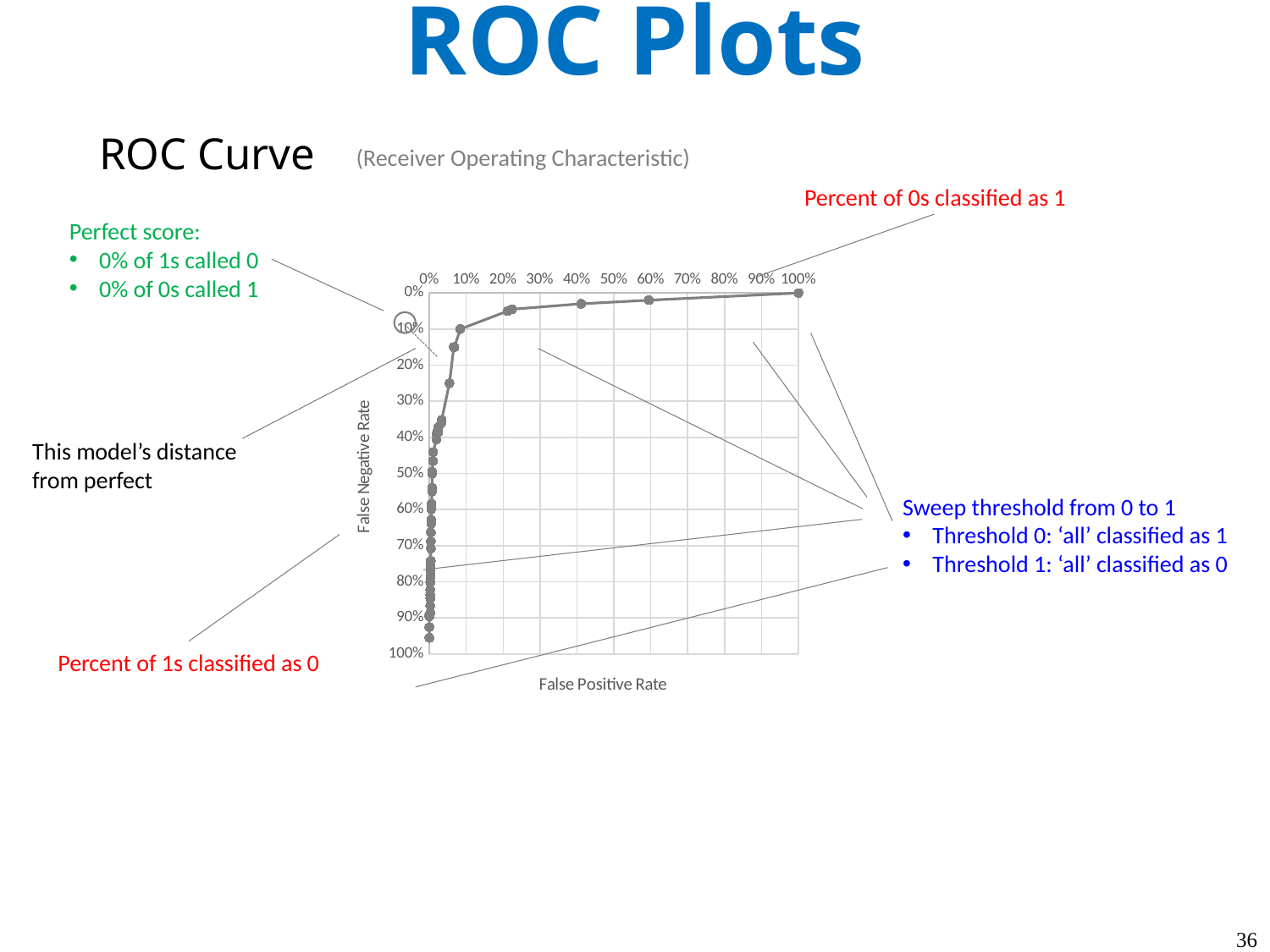
What is the False Negative Rate at a False Positive Rate of 100%? 0% What is the title of the x axis of the chart? False Positive Rate Is the False Negative Rate at a False Positive Rate of 20% greater or less than 10%? less What is the title of the y axis of the chart? False Negative Rate What kind of chart is shown on the slide? Scatter (line) chart Is the False Negative Rate at a False Positive Rate of 50% greater or less than 10%? less Which point has the higher False Negative Rate: the point at a False Positive Rate of 100% or the point at a False Positive Rate of 0%? The point at 0% False Positive Rate What is the highest value shown on the x axis of the chart? 100% As the False Positive Rate increases along the x axis, does the False Negative Rate rise or fall? fall Is the False Negative Rate of the lowest plotted point (at a False Positive Rate near 0%) greater or less than 90%? greater How many data series are plotted on the chart? 1